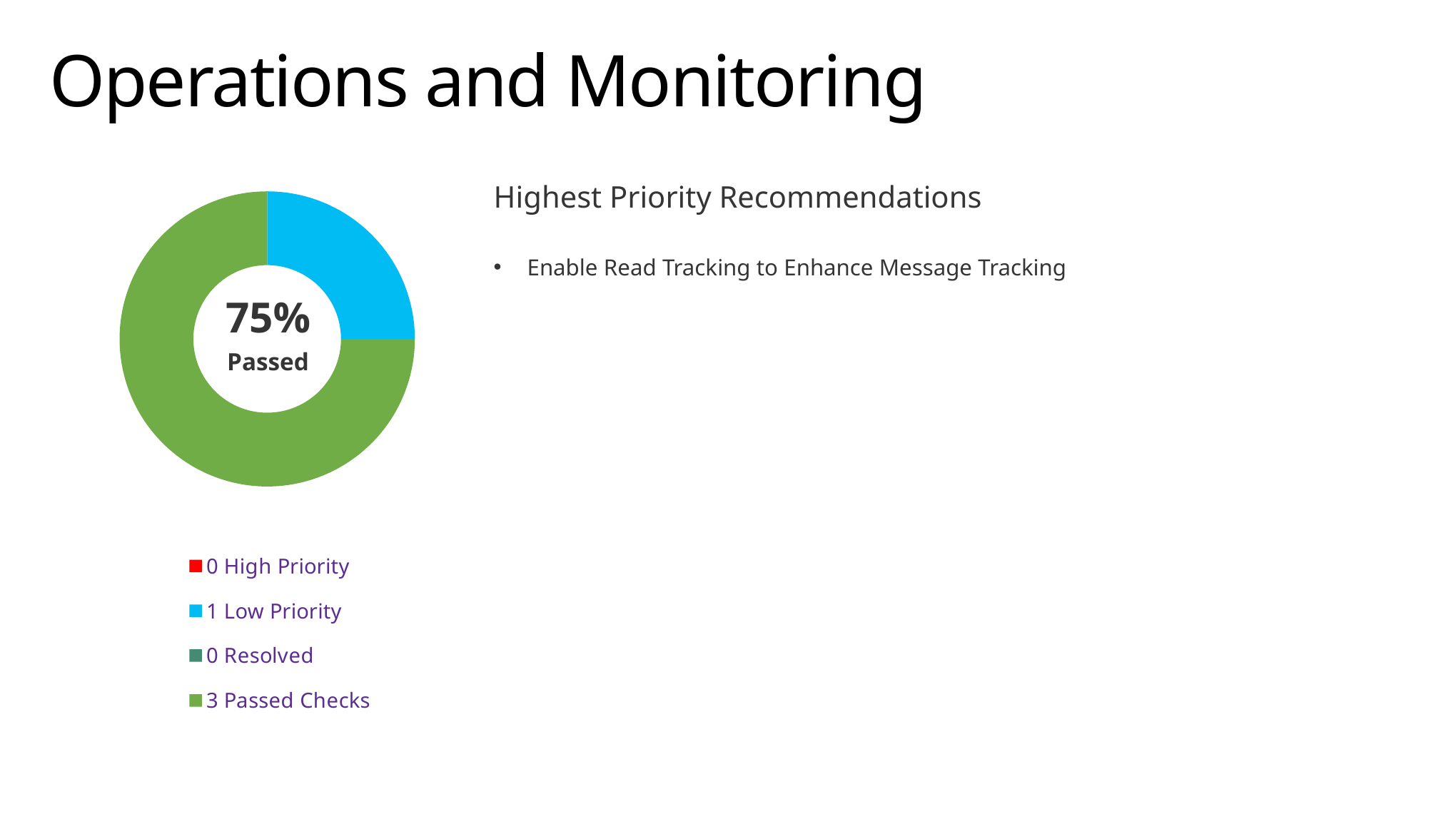
What colour represents Passed Checks in the chart? Green How many Passed Checks does the legend show? 3 How many High Priority items does the legend show? 0 Which category has the highest count in the chart? Passed Checks Which is larger, the number of Passed Checks or the number of Low Priority items? Passed Checks How many Resolved items does the legend show? 0 What percentage is shown in the centre of the donut chart? 75% How many Low Priority items does the legend show? 1 What is the total of all the counts listed in the legend? 4 What kind of chart is shown on the slide? Donut chart What is the difference between the number of Passed Checks and the number of Low Priority items? 2 How many categories does the legend list? 4